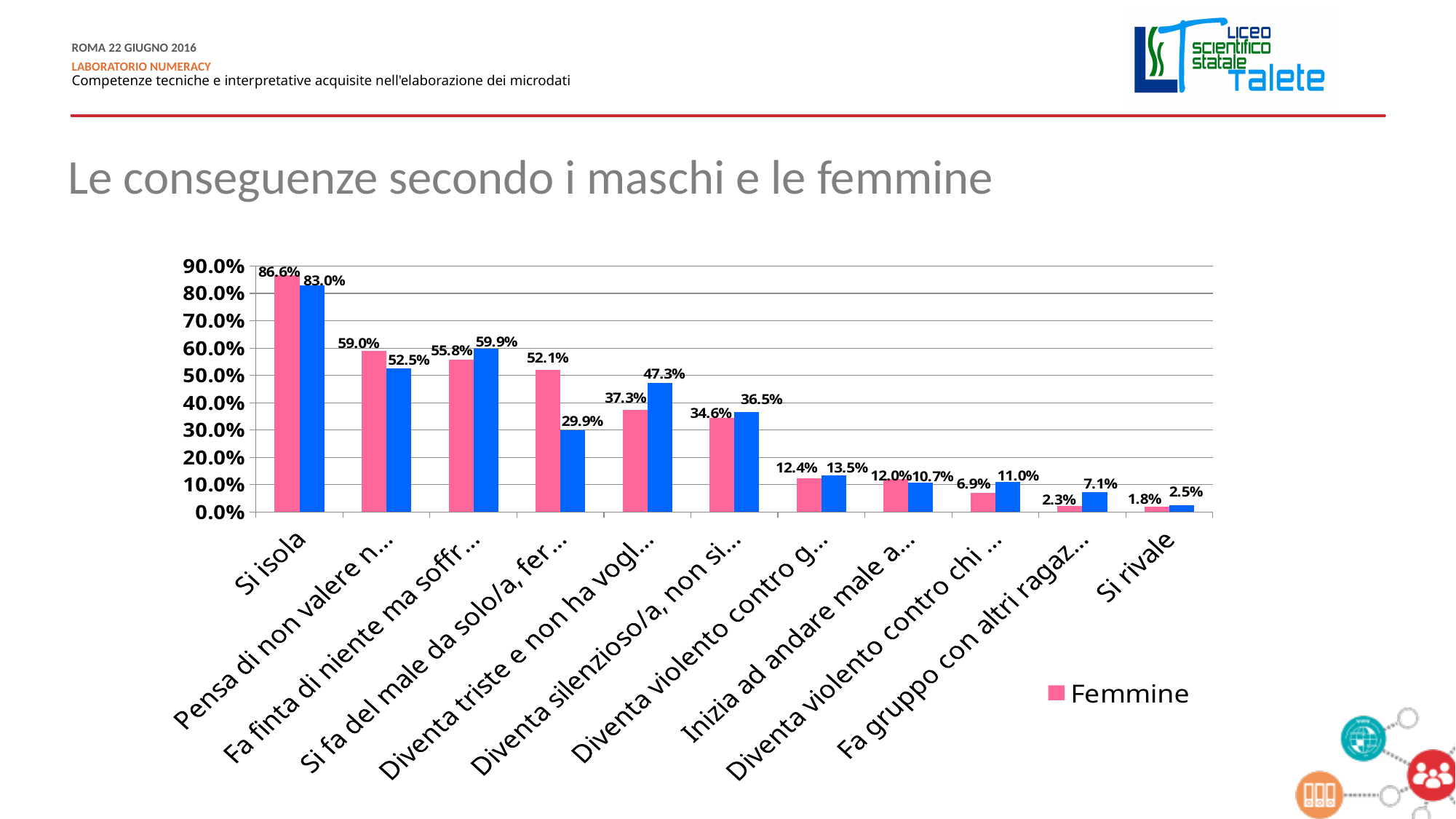
Is the Femmine value for "Si isola" greater or less than 80.0%? greater What is the value of the blue bar for "Si rivale"? 2.5% How many categories are shown on the x axis? 11 What kind of chart is shown on the slide? bar chart What is the title of the slide containing the chart? Le conseguenze secondo i maschi e le femmine Which category has the highest Femmine value? Si isola What is the Femmine value for "Si isola"? 86.6% What is the difference between the Femmine bar and the blue bar for "Si isola"? 3.6% What is the Femmine value for "Si rivale"? 1.8% Which category has the lowest Femmine value? Si rivale For "Si rivale", which is larger: the Femmine bar or the blue bar? the blue bar For "Si isola", which is larger: the Femmine bar or the blue bar? the Femmine bar